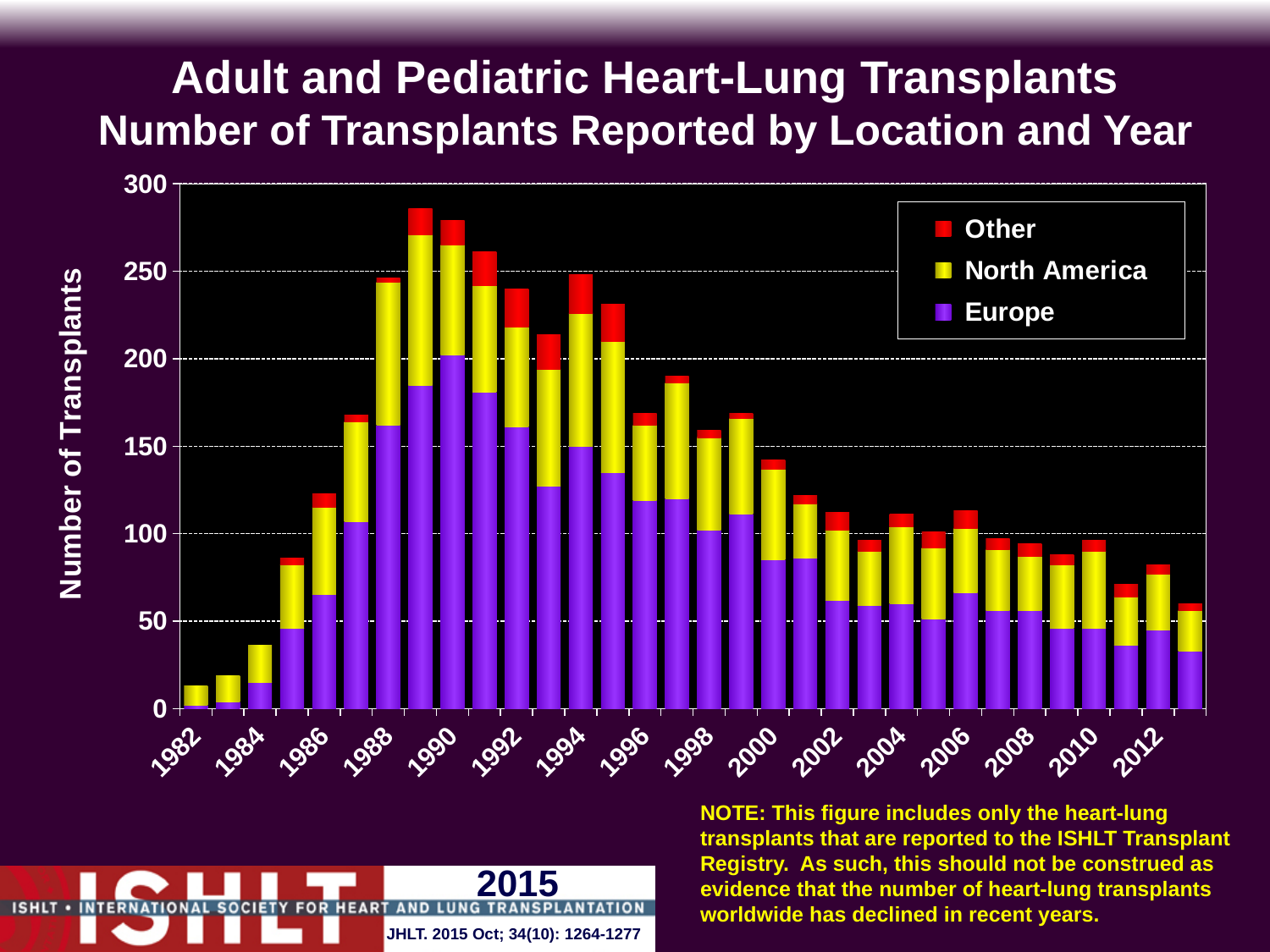
What kind of chart is shown on the slide? Stacked bar chart Which year has the lowest total number of heart-lung transplants? 1982 What are the three series listed in the legend? Other, North America, Europe Which year has a larger total number of transplants, 1986 or 1987? 1987 Which colour represents Europe in the chart? Purple Is the total number of transplants in 1982 greater or less than 50? less Which year has the highest total number of heart-lung transplants? 1989 How many series does the legend list? 3 Is the total number of transplants in 1989 greater or less than 250? greater Do the total numbers of transplants generally rise or fall from 1989 to 2013? fall Is the total number of transplants in 2012 greater or less than 100? less